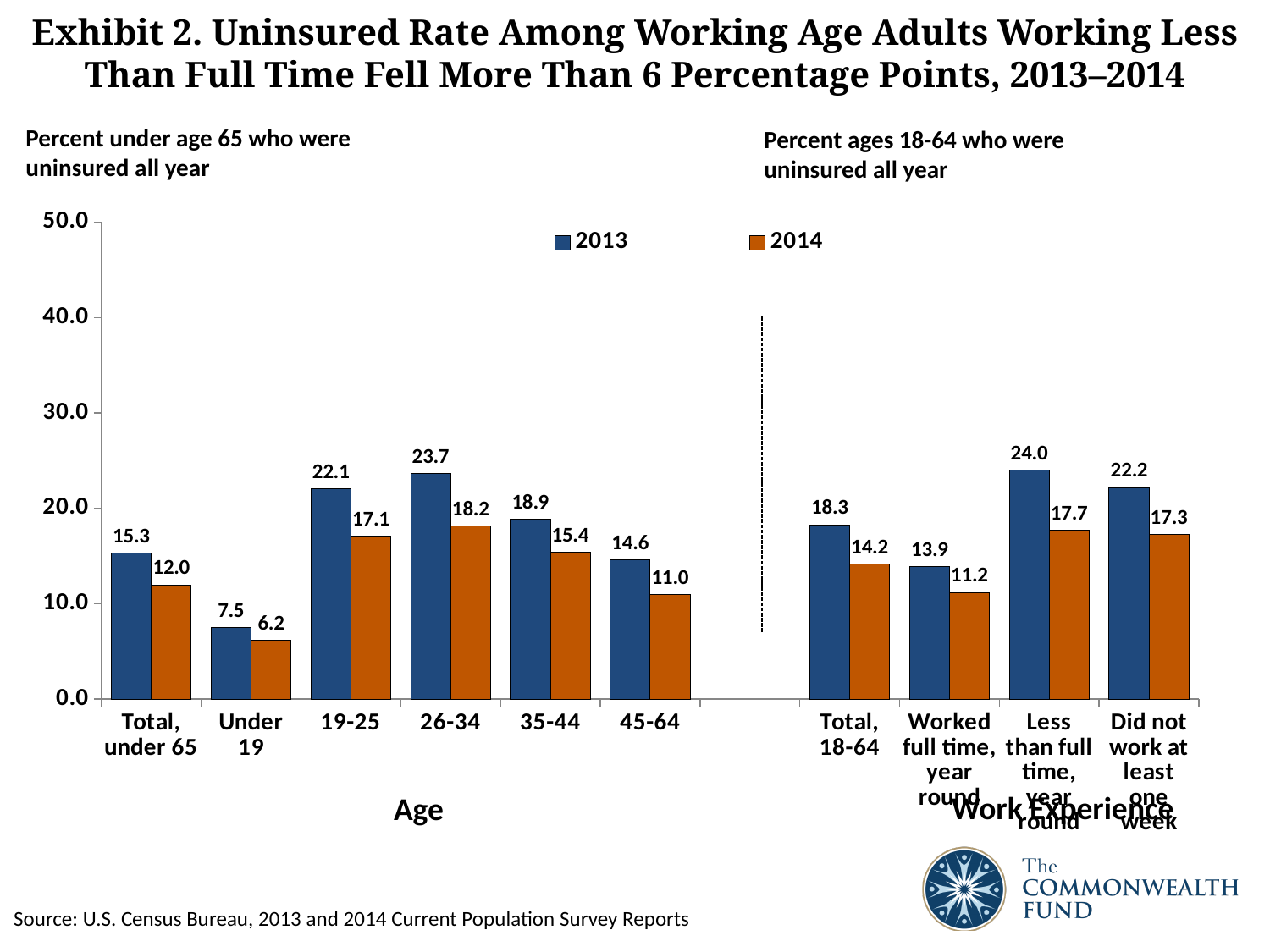
Which was larger in 2014: the uninsured rate for the 45-64 age group or for those who worked full time, year round? Worked full time, year round How many series does the legend list? 2 What was the 2013 uninsured rate for the 26-34 age group? 23.7 Which age group had the lowest 2014 uninsured rate? Under 19 Which colour represents 2014 in the chart? Orange What is the difference between the 2013 and 2014 uninsured rates for the 19-25 age group? 5.0 What was the 2014 uninsured rate for adults who worked less than full time, year round? 17.7 What type of chart is shown on the slide? Bar chart What was the 2014 uninsured rate for the Under 19 group? 6.2 By how many percentage points did the uninsured rate for adults working less than full time, year round fall from 2013 to 2014? 6.3 How many categories are shown under the Work Experience group? 4 Which age group had the highest 2013 uninsured rate? 26-34